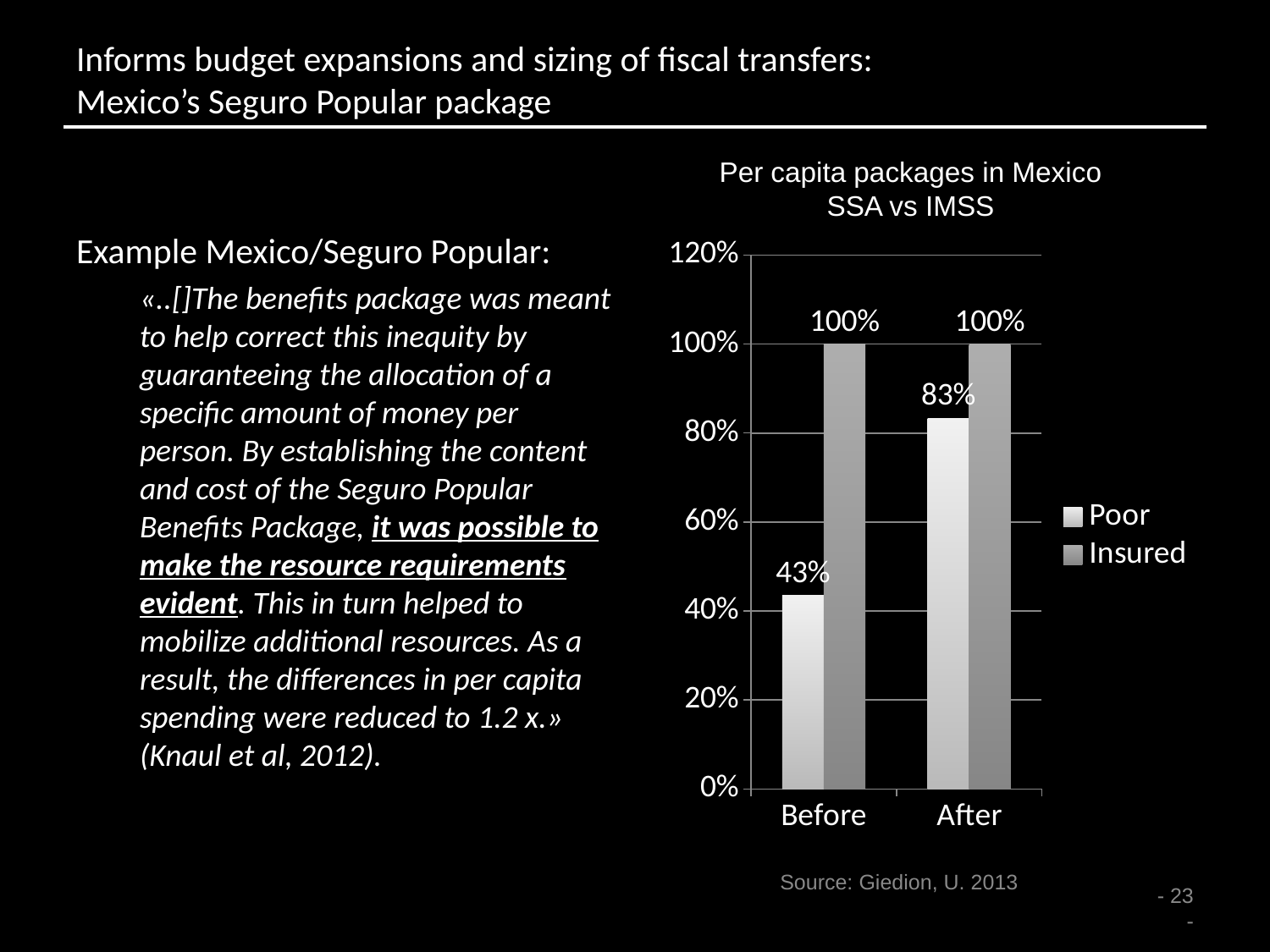
Which category has the lower value for the Poor series, Before or After? Before What is the value for Poor in the After category? 83% What is the difference between the Insured and Poor values in the Before category? 57% What is the value for Insured in the After category? 100% What is the value for Poor in the Before category? 43% What is the value for Insured in the Before category? 100% Does the Poor series rise or fall from Before to After? rise What is the difference between the Insured and Poor values in the After category? 17% How many categories are shown on the x axis? 2 What kind of chart is shown on the slide? bar chart How many series does the legend list? 2 Is the Poor value in the Before category greater or less than 40%? greater